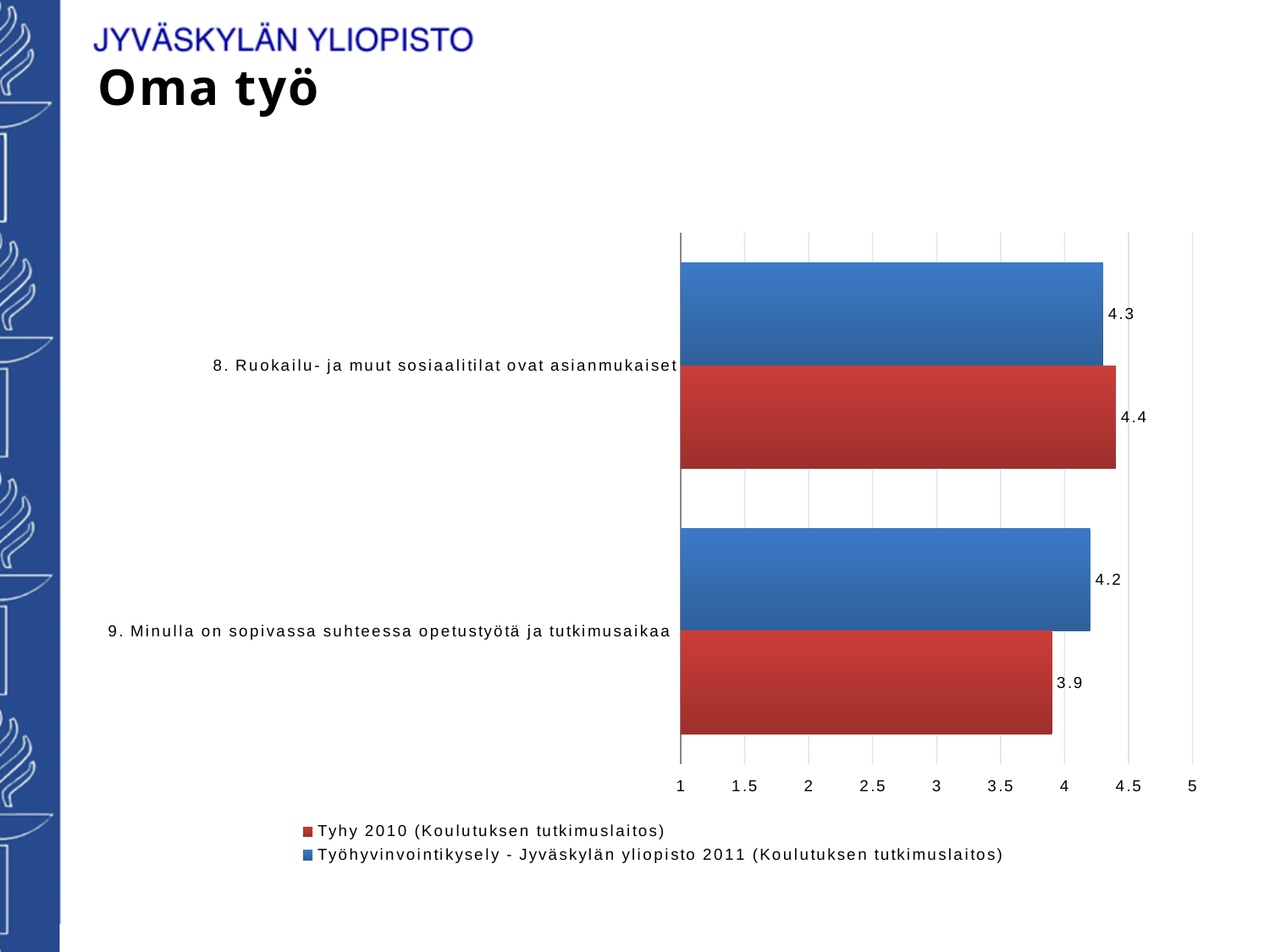
Which bar has the highest value in the chart? Tyhy 2010 for "8. Ruokailu- ja muut sosiaalitilat ovat asianmukaiset" (4.4) What kind of chart is shown on the slide? Bar chart What is the value for "9. Minulla on sopivassa suhteessa opetustyötä ja tutkimusaikaa" in the Tyhy 2010 (Koulutuksen tutkimuslaitos) series? 3.9 How many series does the legend list? 2 For "9. Minulla on sopivassa suhteessa opetustyötä ja tutkimusaikaa", which series has the larger value, Tyhy 2010 or Työhyvinvointikysely 2011? Työhyvinvointikysely - Jyväskylän yliopisto 2011 What is the value for "8. Ruokailu- ja muut sosiaalitilat ovat asianmukaiset" in the Työhyvinvointikysely - Jyväskylän yliopisto 2011 series? 4.3 Which colour represents the Tyhy 2010 (Koulutuksen tutkimuslaitos) series? Red What is the value for "9. Minulla on sopivassa suhteessa opetustyötä ja tutkimusaikaa" in the Työhyvinvointikysely - Jyväskylän yliopisto 2011 series? 4.2 What is the value for "8. Ruokailu- ja muut sosiaalitilat ovat asianmukaiset" in the Tyhy 2010 (Koulutuksen tutkimuslaitos) series? 4.4 What is the difference between the 2011 and 2010 values for "9. Minulla on sopivassa suhteessa opetustyötä ja tutkimusaikaa"? 0.3 Which bar has the lowest value in the chart? Tyhy 2010 for "9. Minulla on sopivassa suhteessa opetustyötä ja tutkimusaikaa" (3.9) How many categories (statements) are plotted in the chart? 2